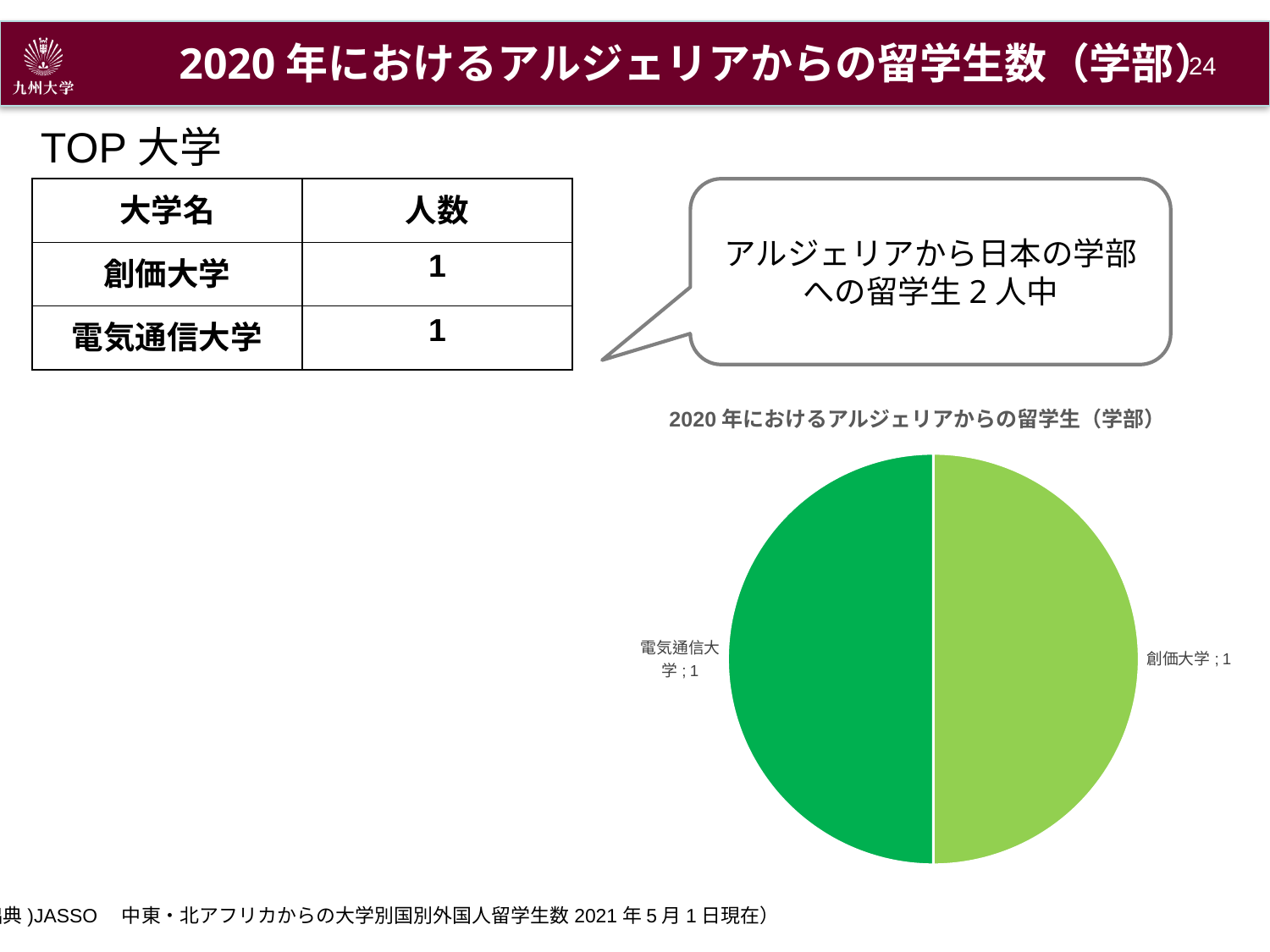
How many slices does the pie chart have? 2 What share of the pie does 創価大学 represent? 50% What is the value for 創価大学 in the pie chart? 1 What type of chart is shown on the slide? pie chart What is the total of all slices in the pie chart? 2 What share of the pie does 電気通信大学 represent? 50% What is the difference between the values for 創価大学 and 電気通信大学? 0 What is the title of the pie chart? 2020年におけるアルジェリアからの留学生（学部） Which slice of the pie chart is shown in the darker green colour? 電気通信大学 What is the value for 電気通信大学 in the pie chart? 1